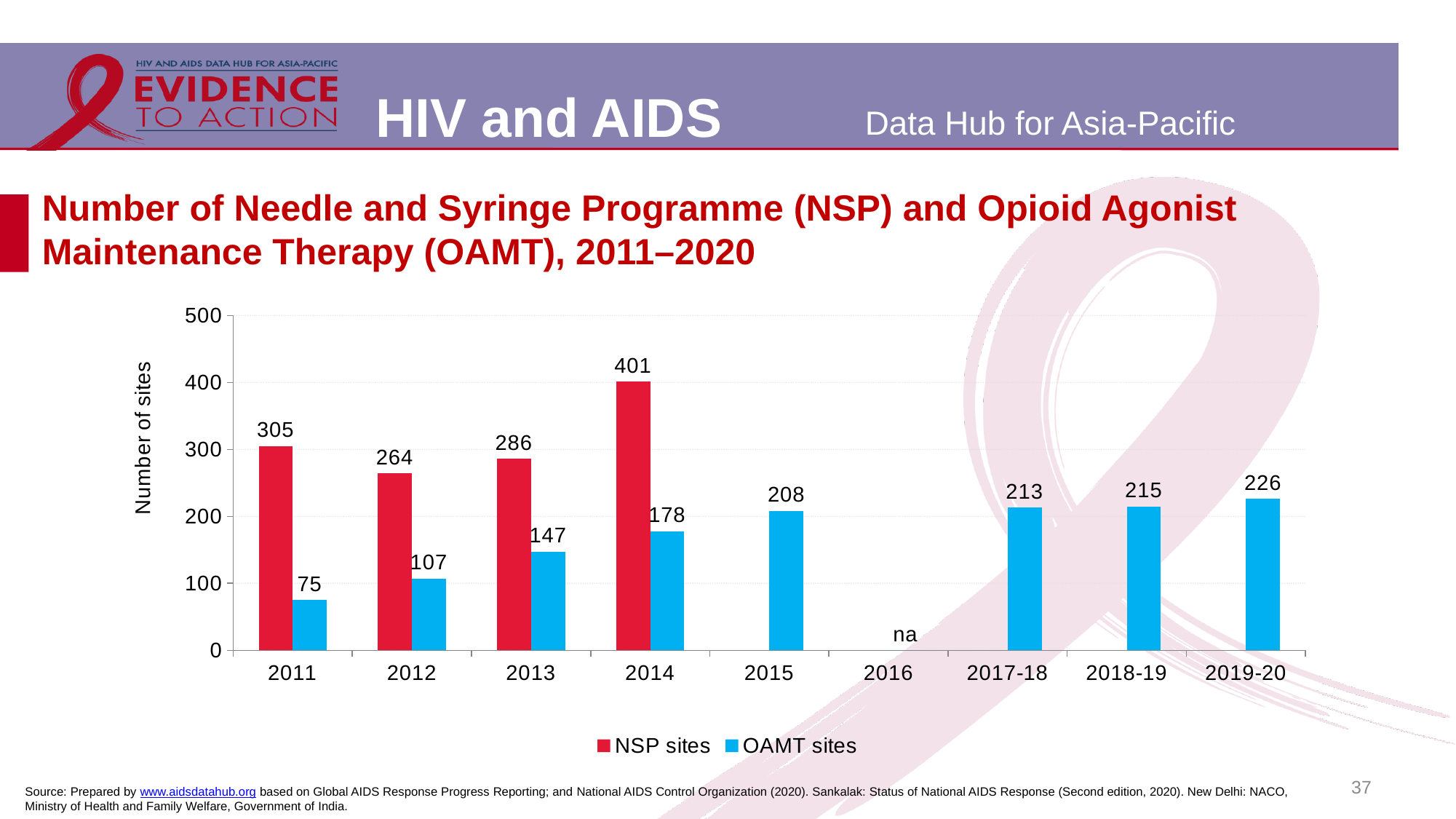
What is the number of NSP sites in 2014? 401 What is the number of OAMT sites in 2011? 75 Which year has the lowest number of OAMT sites? 2011 What is the number of OAMT sites in 2019-20? 226 Which year has the highest number of NSP sites? 2014 How many year categories are shown on the x axis? 9 Do the OAMT site values rise or fall from 2011 to 2014? Rise What is the difference between NSP sites and OAMT sites in 2013? 139 How many series does the legend list? 2 Which is larger, the number of OAMT sites in 2015 or in 2017-18? 2017-18 What kind of chart is shown on the slide? Bar chart What label is shown for 2016 instead of a bar? na